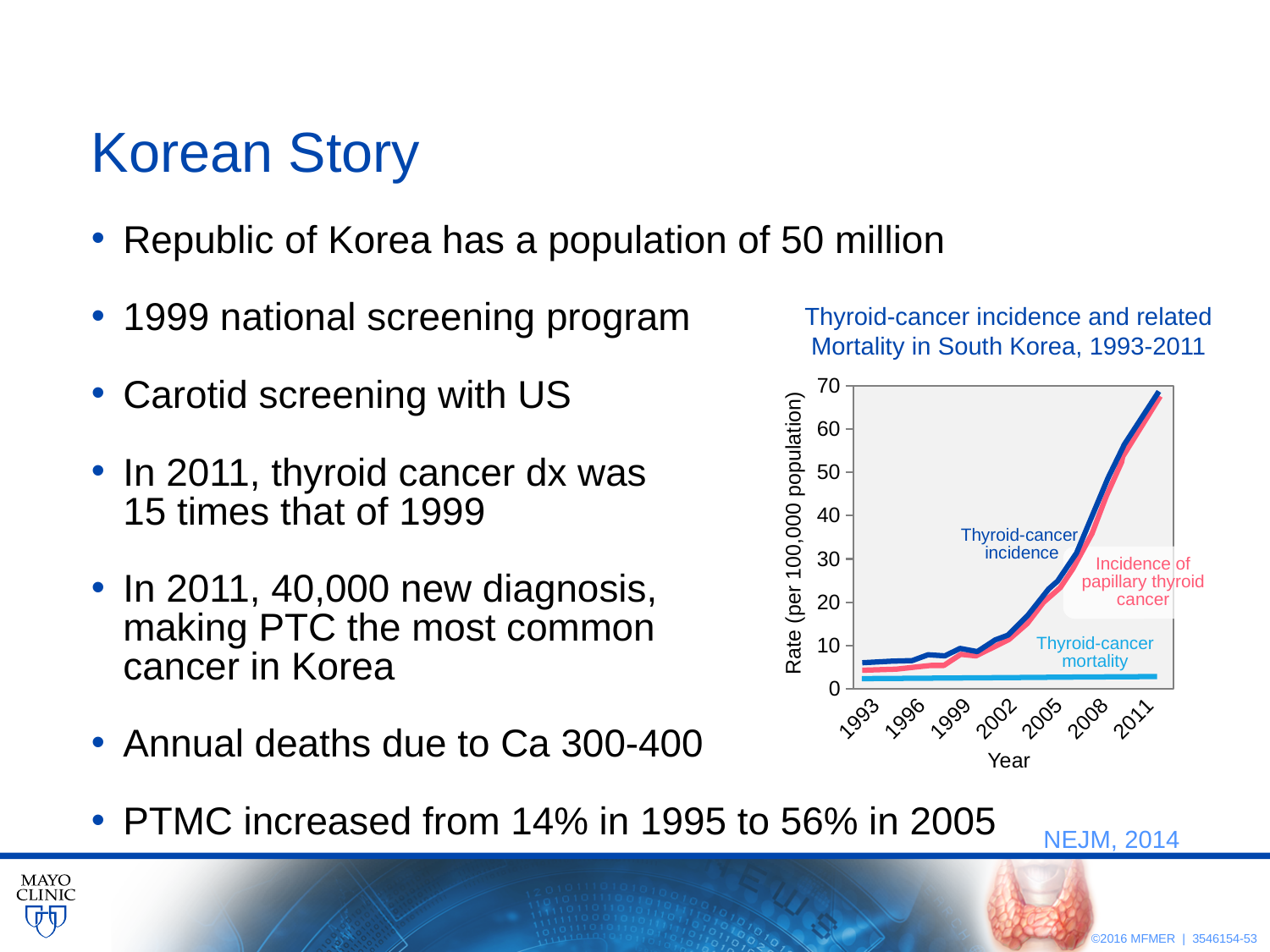
Is the thyroid-cancer incidence rate in 2008 greater or less than 30? greater What is the label of the y axis of the chart? Rate (per 100,000 population) How many year labels are shown on the x axis of the chart? 7 Is the thyroid-cancer incidence rate in 1993 greater or less than 10? less Does the thyroid-cancer incidence rate rise or fall from 1993 to 2011? rise Is the thyroid-cancer incidence rate in 2011 greater or less than 60? greater What kind of chart is shown on the slide? line chart How many data series are plotted in the chart? 3 What is the title of the chart on the slide? Thyroid-cancer incidence and related Mortality in South Korea, 1993-2011 In 2011, which is larger: thyroid-cancer incidence or thyroid-cancer mortality? Thyroid-cancer incidence Which series has the lowest values across the chart? Thyroid-cancer mortality